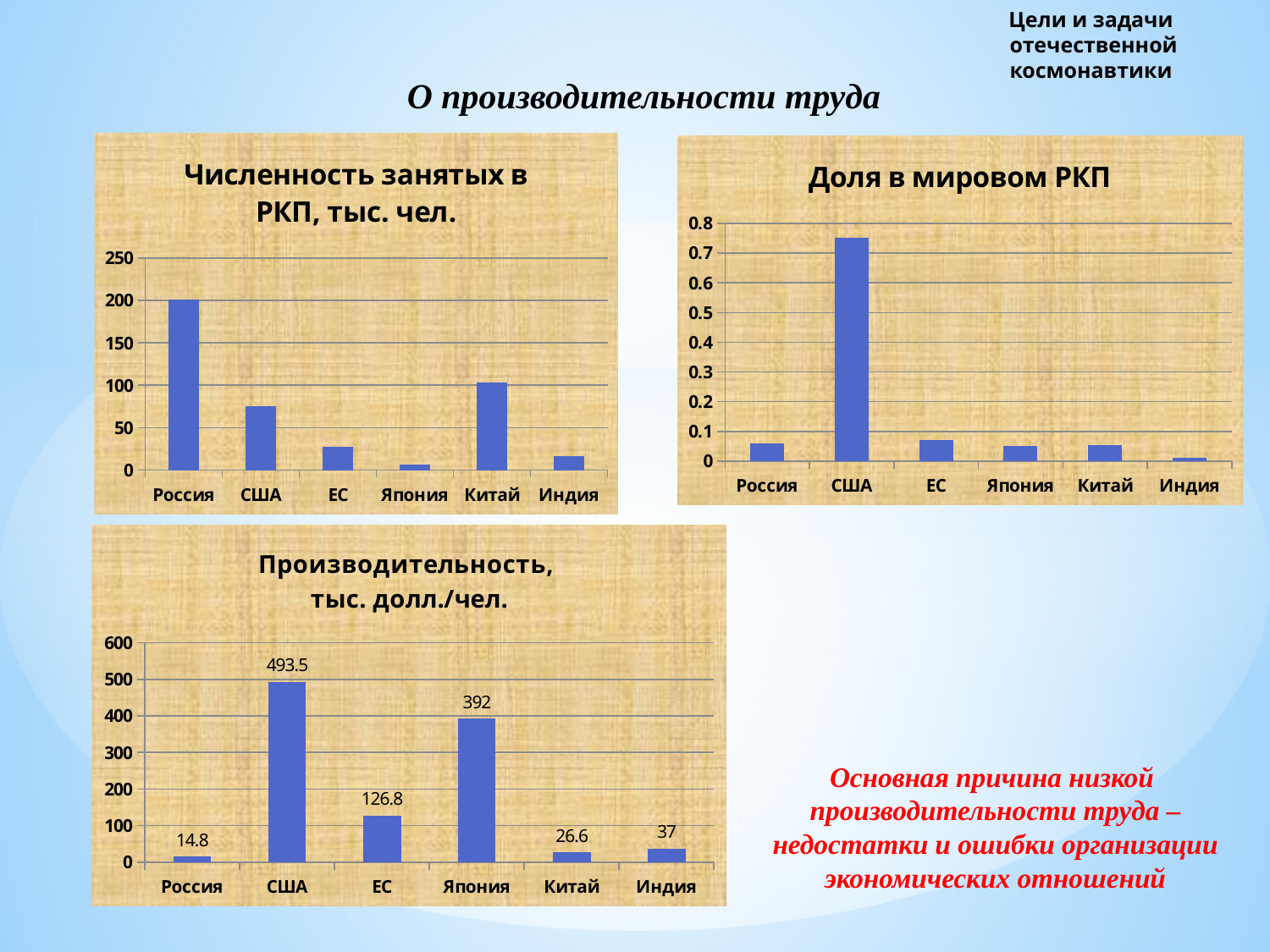
In the chart titled "Производительность, тыс. долл./чел.", which category has the lowest value? Россия In the chart titled "Производительность, тыс. долл./чел.", what is the value for США? 493.5 In the chart titled "Численность занятых в РКП, тыс. чел.", which category has the lowest value? Япония In the chart titled "Производительность, тыс. долл./чел.", which category has the highest value? США In the chart titled "Производительность, тыс. долл./чел.", which is larger, the value for Китай or the value for Индия? Индия In the chart titled "Доля в мировом РКП", which category has the highest value? США In the chart titled "Производительность, тыс. долл./чел.", what is the difference between the values for США and Япония? 101.5 In the chart titled "Численность занятых в РКП, тыс. чел.", which category has the highest value? Россия In the chart titled "Численность занятых в РКП, тыс. чел.", is the value for США greater or less than 100? less In the chart titled "Производительность, тыс. долл./чел.", what is the difference between the values for ЕС and Россия? 112 In the chart titled "Доля в мировом РКП", is the value for США greater or less than 0.7? greater In the chart titled "Производительность, тыс. долл./чел.", what is the value for Япония? 392